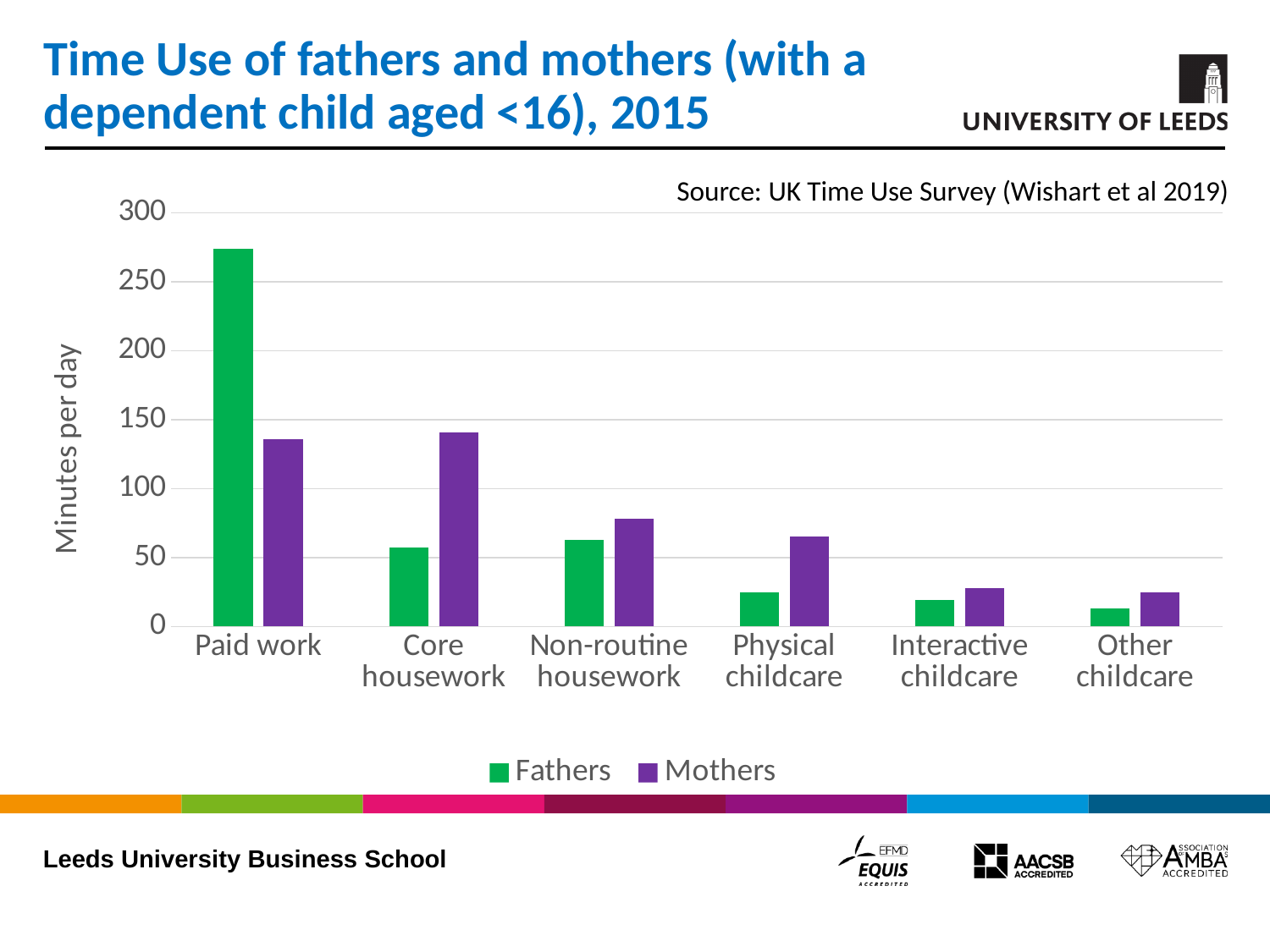
Is the value for Fathers in Other childcare greater or less than 50? less What kind of chart is shown on the slide? bar chart Is the value for Mothers in Physical childcare greater or less than 50? greater How many series does the legend list? 2 For Paid work, which is larger: the value for Fathers or for Mothers? Fathers Is the value for Fathers in Paid work greater or less than 250? greater What is the label on the y axis? Minutes per day For Core housework, which is larger: the value for Fathers or for Mothers? Mothers Which category has the highest value for Fathers? Paid work How many activity categories are shown on the x axis? 6 Which category has the lowest value for Fathers? Other childcare